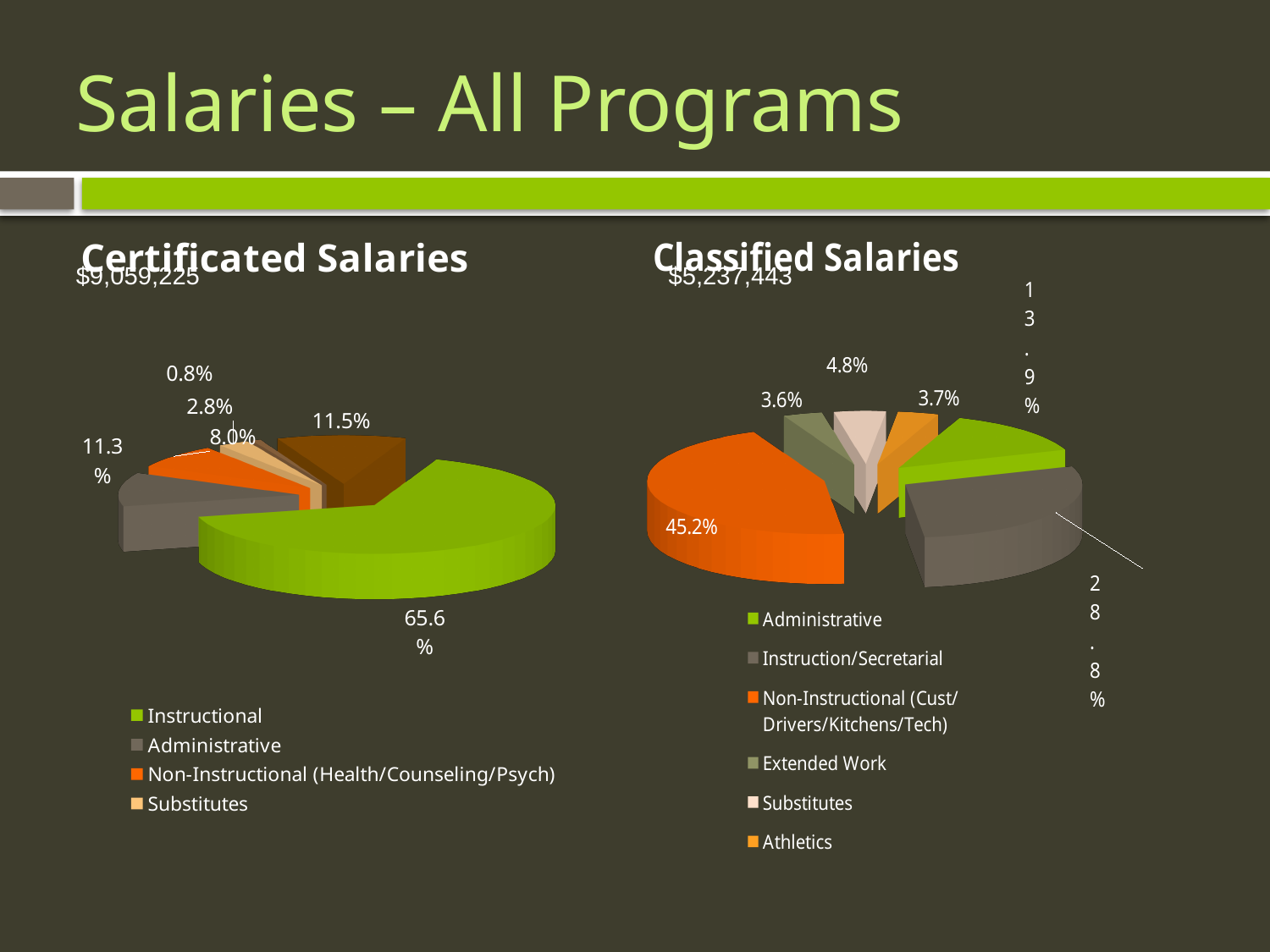
In the Classified Salaries chart, what share is labelled for Non-Instructional (Cust/Drivers/Kitchens/Tech)? 45.2% In the Classified Salaries chart, which is larger, the Administrative slice or the Substitutes slice? Administrative In the Classified Salaries chart, what is the difference in percentage points between the Non-Instructional (Cust/Drivers/Kitchens/Tech) slice and the Instruction/Secretarial slice? 16.4 percentage points In the Certificated Salaries chart, which category has the largest slice? Instructional What total dollar amount is shown under the Certificated Salaries title? $9,059,225 In the Classified Salaries chart, which category has the largest slice? Non-Instructional (Cust/Drivers/Kitchens/Tech) In the Certificated Salaries chart, what share is labelled for Instructional? 65.6% How many entries does the legend of the Certificated Salaries chart list? 4 How many entries does the legend of the Classified Salaries chart list? 6 What kind of chart is the Certificated Salaries chart? Pie chart In the Classified Salaries chart, what share is labelled for Instruction/Secretarial? 28.8%